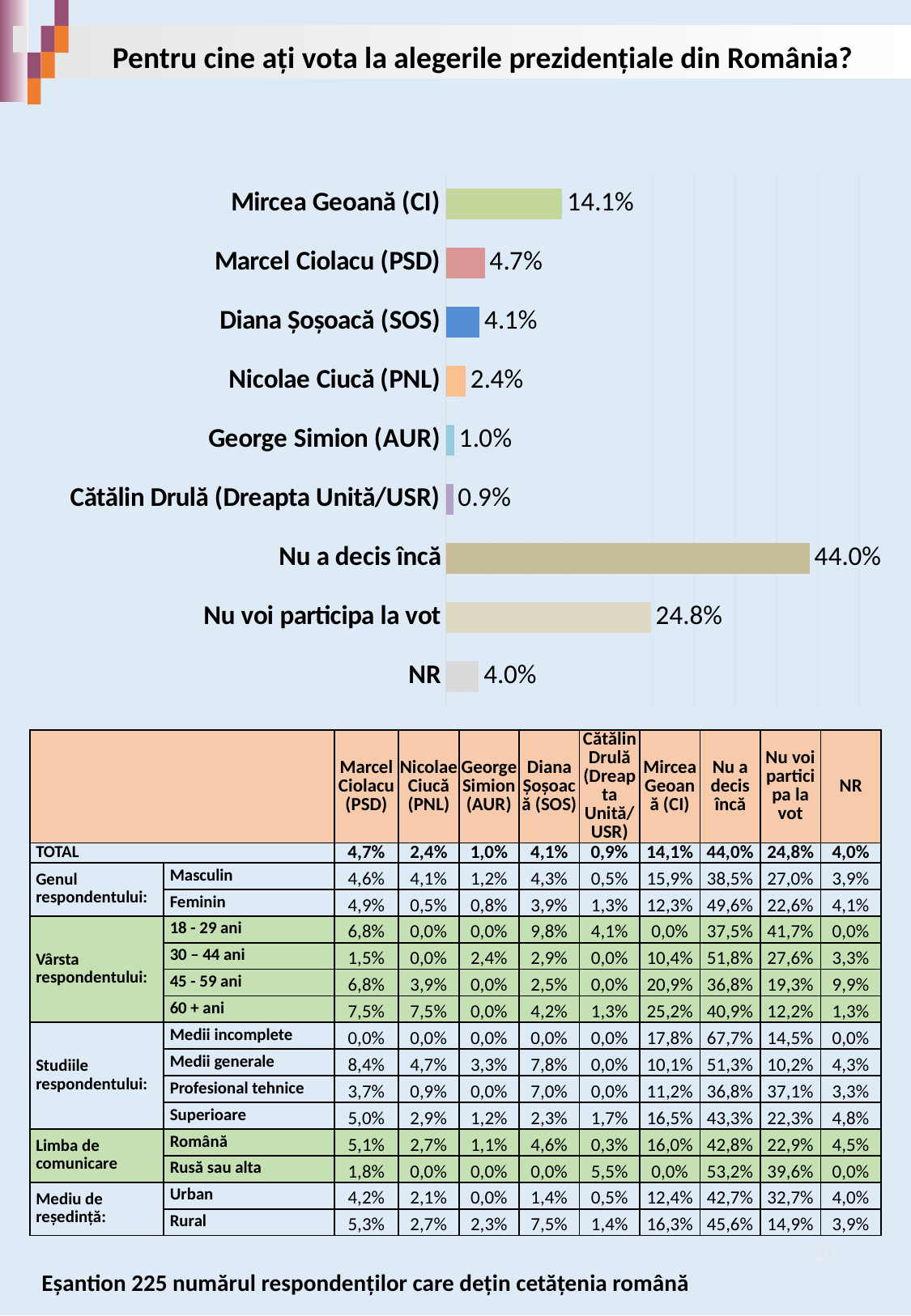
Which candidate has the highest value among the named candidates in the bar chart? Mircea Geoană (CI) Which is larger in the bar chart, the value for Marcel Ciolacu (PSD) or the value for Diana Șoșoacă (SOS)? Marcel Ciolacu (PSD) What is the difference between the values for Mircea Geoană (CI) and Marcel Ciolacu (PSD) in the bar chart? 9.4% Which category has the highest value in the bar chart? Nu a decis încă What percentage is shown for "Nu a decis încă" in the bar chart? 44.0% What is the difference between the values for "Nu a decis încă" and "Nu voi participa la vot" in the bar chart? 19.2% How many categories are shown in the bar chart? 9 What is the value for Nicolae Ciucă (PNL) in the bar chart? 2.4% What type of chart is shown on the slide? Bar chart Which category has the lowest value in the bar chart? Cătălin Drulă (Dreapta Unită/USR) What value does the bar chart show for "Nu voi participa la vot"? 24.8% What is the value shown for Mircea Geoană (CI) in the bar chart? 14.1%